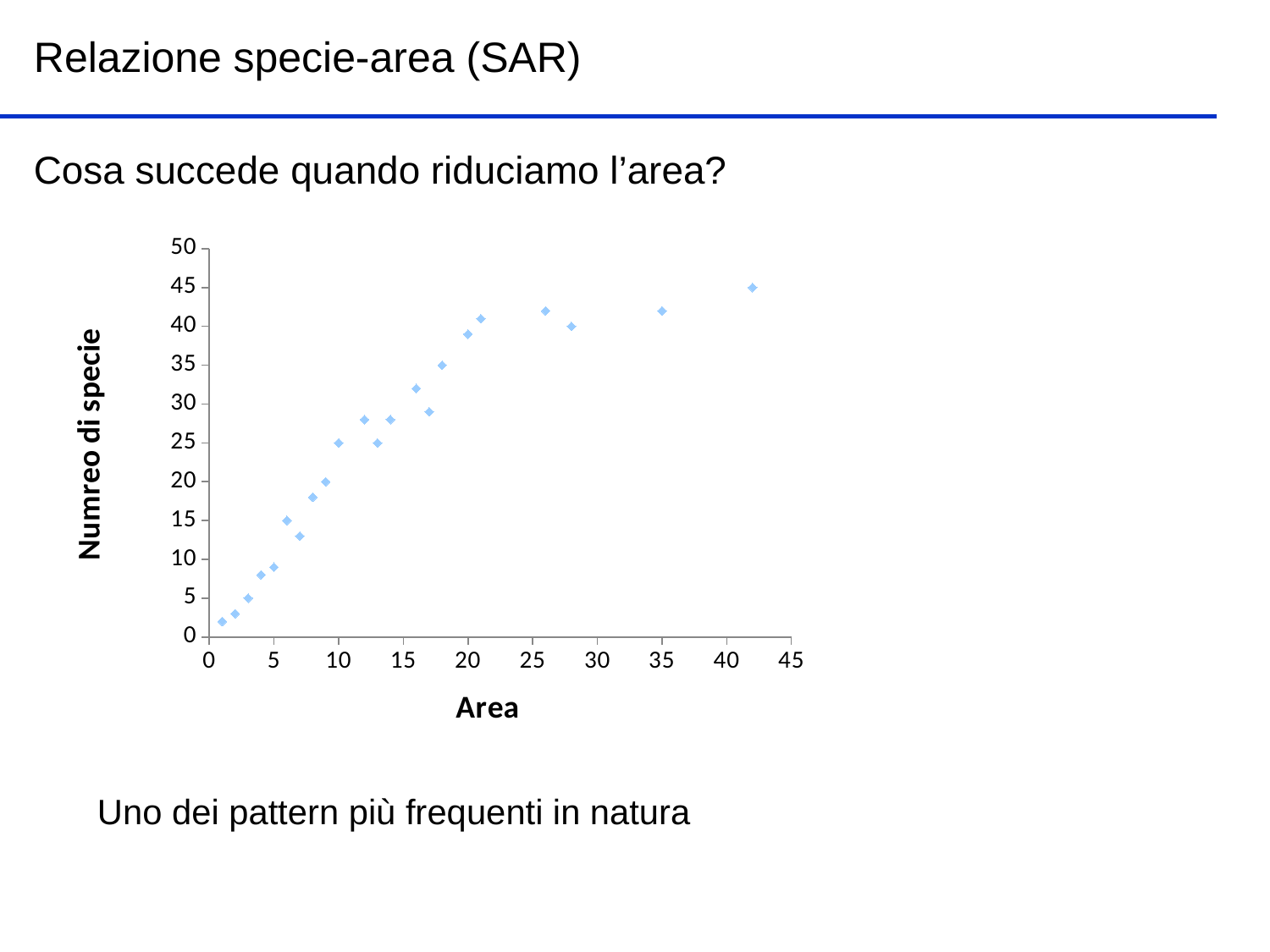
Is the number of species for the point at area 42 greater or less than 40? greater Overall, does the number of species rise or fall as the area increases along the x axis? Rises What is the title of the x axis? Area Is the number of species for the point at area 20 greater or less than 35? greater Is the number of species for the point at area 1 greater or less than 5? less Which point has the lowest number of species? The point at area 1 (the leftmost point) Which point has more species, the one at area 10 or the one at area 5? The point at area 10 What is the highest tick value shown on the y axis? 50 Does the point with the largest area also have the highest number of species? Yes What kind of chart is shown on the slide? Scatter chart